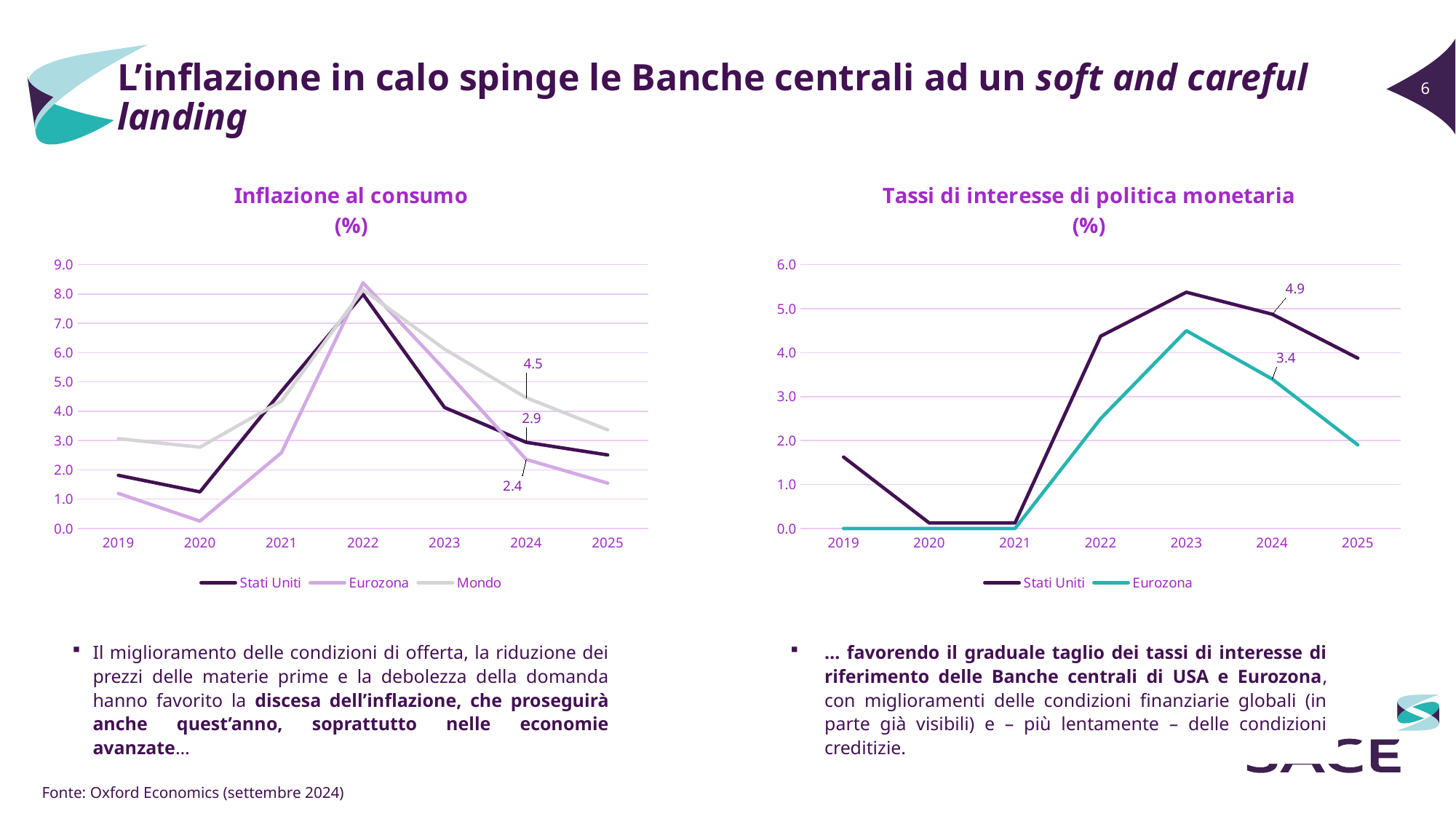
In the 'Tassi di interesse di politica monetaria (%)' chart, in which year does the Eurozona series reach its highest value? 2023 In the 'Inflazione al consumo (%)' chart, what is the value for Eurozona in 2024? 2.4 In the 'Tassi di interesse di politica monetaria (%)' chart, what is the value for Stati Uniti in 2024? 4.9 In the 'Inflazione al consumo (%)' chart, in which year does the Stati Uniti series reach its highest value? 2022 How many series does the legend of the 'Inflazione al consumo (%)' chart list? 3 In the 'Tassi di interesse di politica monetaria (%)' chart, what is the difference between the Stati Uniti and Eurozona values in 2024? 1.5 In the 'Inflazione al consumo (%)' chart, what is the difference between the Mondo and Eurozona values in 2024? 2.1 In the 'Inflazione al consumo (%)' chart, which series has the higher value in 2024, Stati Uniti or Eurozona? Stati Uniti What kind of chart is the 'Tassi di interesse di politica monetaria (%)' chart? Line chart In the 'Inflazione al consumo (%)' chart, what is the value for Mondo in 2024? 4.5 In the 'Tassi di interesse di politica monetaria (%)' chart, is the Stati Uniti value for 2023 greater or less than 5.0? greater How many years are shown on the x axis of the 'Tassi di interesse di politica monetaria (%)' chart? 7